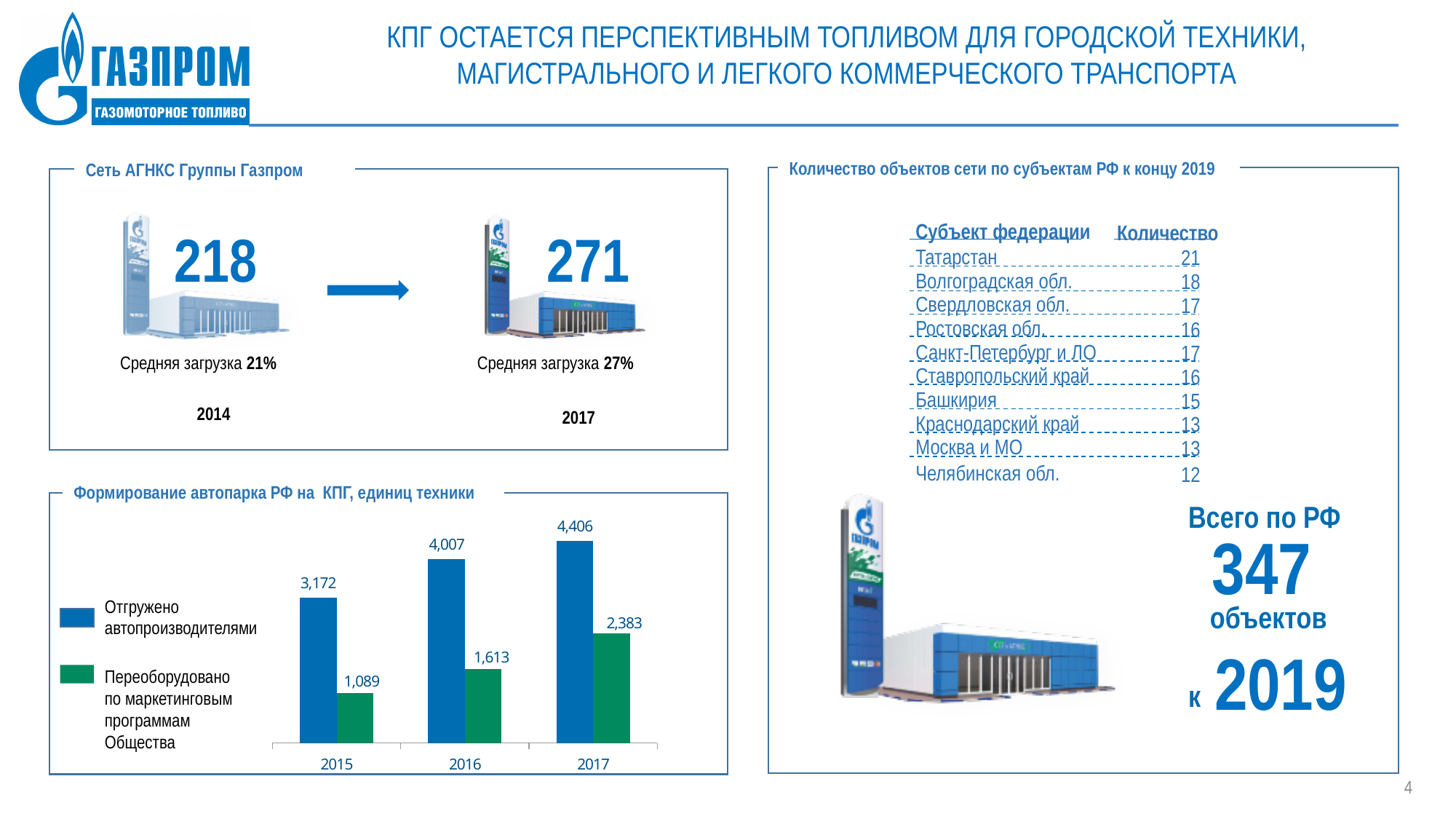
In the chart "Формирование автопарка РФ на КПГ, единиц техники", what is the value for "Отгружено автопроизводителями" in 2017? 4,406 What type of chart is shown under the title "Формирование автопарка РФ на КПГ, единиц техники"? bar chart In the chart "Формирование автопарка РФ на КПГ, единиц техники", what is the value for "Отгружено автопроизводителями" in 2015? 3,172 How many series does the legend of the chart "Формирование автопарка РФ на КПГ, единиц техники" list? 2 In the chart "Формирование автопарка РФ на КПГ, единиц техники", what is the difference between "Отгружено автопроизводителями" and "Переоборудовано по маркетинговым программам Общества" in 2017? 2,023 In the chart "Формирование автопарка РФ на КПГ, единиц техники", what is the value for "Переоборудовано по маркетинговым программам Общества" in 2017? 2,383 In the chart "Формирование автопарка РФ на КПГ, единиц техники", which year has the highest value for "Отгружено автопроизводителями"? 2017 In the chart "Формирование автопарка РФ на КПГ, единиц техники", what is the difference between the "Отгружено автопроизводителями" values for 2016 and 2015? 835 In the chart "Формирование автопарка РФ на КПГ, единиц техники", do the values for "Переоборудовано по маркетинговым программам Общества" rise or fall from 2015 to 2017? rise In the chart "Формирование автопарка РФ на КПГ, единиц техники", which year has the lowest value for "Переоборудовано по маркетинговым программам Общества"? 2015 In the chart "Формирование автопарка РФ на КПГ, единиц техники", which is larger in 2016: "Отгружено автопроизводителями" or "Переоборудовано по маркетинговым программам Общества"? Отгружено автопроизводителями In the chart "Формирование автопарка РФ на КПГ, единиц техники", what is the value for "Переоборудовано по маркетинговым программам Общества" in 2016? 1,613